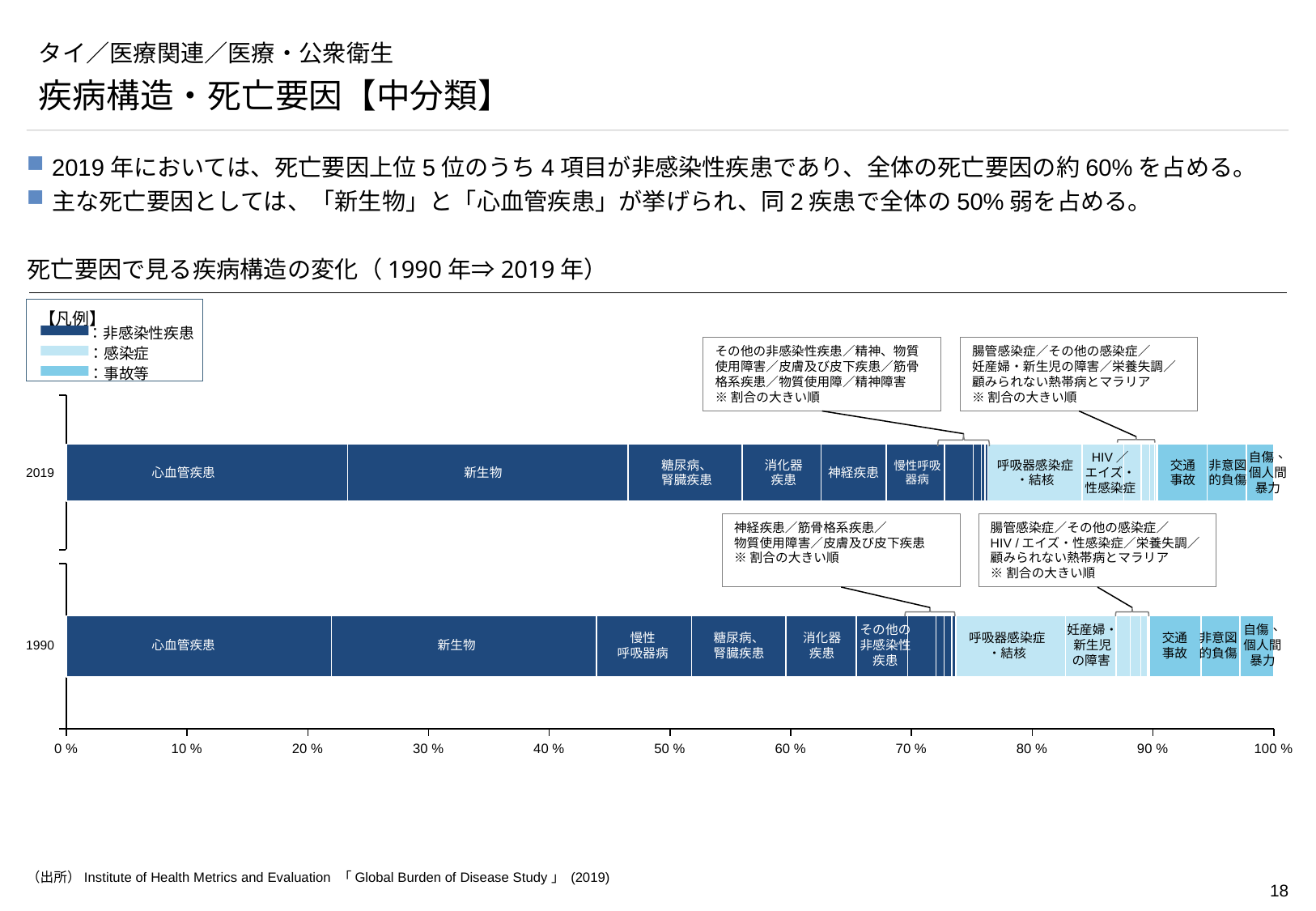
Which years are compared in the chart? 1990 and 2019 Which category appears as the leftmost segment of both the 1990 and 2019 bars? 心血管疾患 How many years (bars) are plotted in the chart? 2 How many categories does the legend (凡例) list? 3 Is the share of 心血管疾患 in the 2019 bar greater or less than 20%? greater In the 2019 bar, is the combined share of the dark-blue 非感染性疾患 segments greater or less than 70%? greater Is the combined share of 心血管疾患 and 新生物 in the 2019 bar greater or less than 50%? less In the 2019 bar, which segment is larger: 心血管疾患 or 糖尿病、腎臓疾患? 心血管疾患 According to the legend, which colour represents 感染症? Light blue Is the 慢性呼吸器病 segment larger in the 1990 bar or the 2019 bar? 1990 What kind of chart is used to show the change in disease structure by cause of death? Stacked bar chart In the 1990 bar, which segment is larger: 呼吸器感染症・結核 or 交通事故? 呼吸器感染症・結核